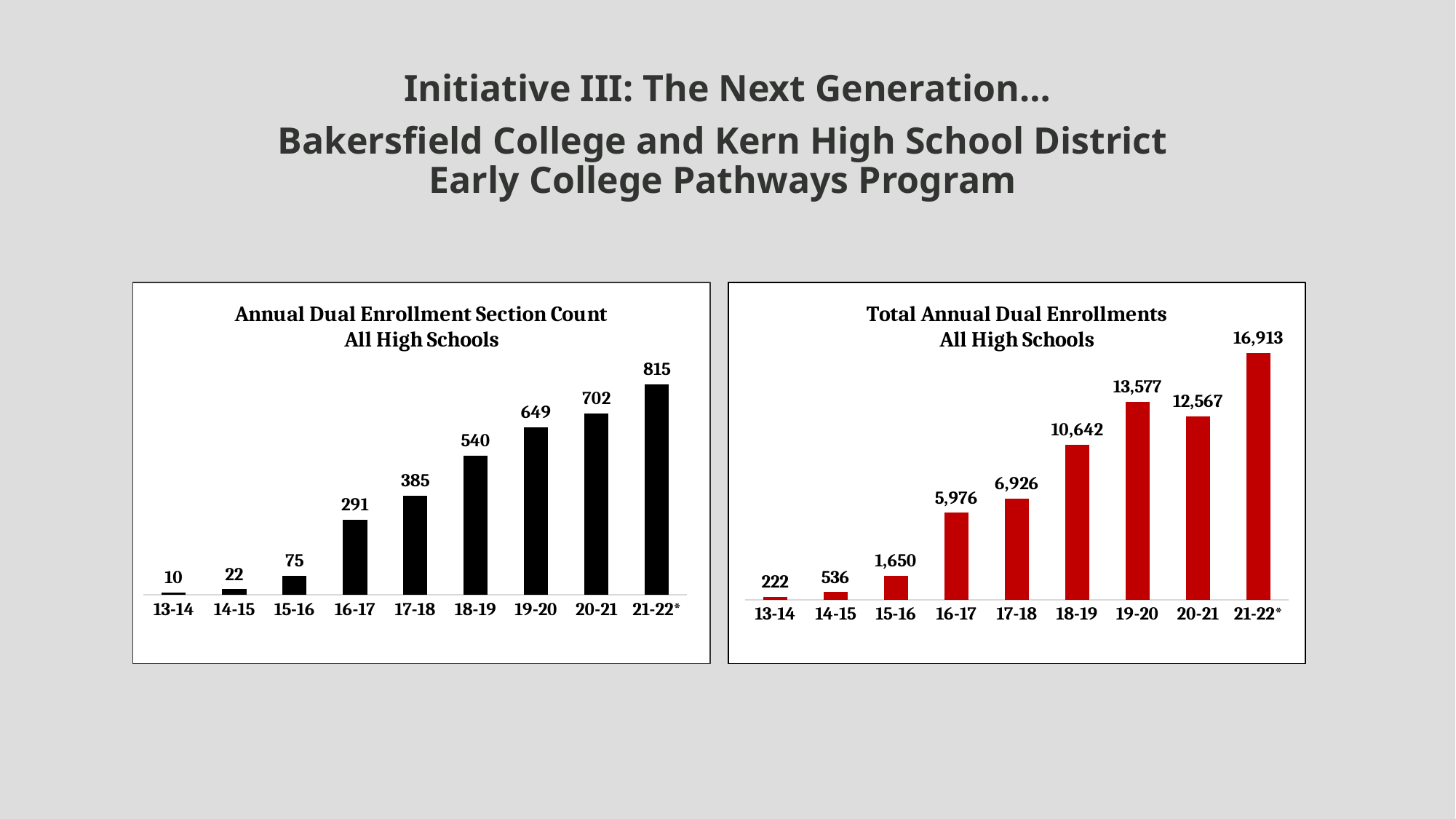
In the 'Annual Dual Enrollment Section Count All High Schools' chart, which is larger, the value for 16-17 or the value for 17-18? 17-18 In the 'Annual Dual Enrollment Section Count All High Schools' chart, what is the value for 18-19? 540 In the 'Annual Dual Enrollment Section Count All High Schools' chart, what is the difference between the values for 21-22* and 20-21? 113 How many years are shown on the x axis of the 'Annual Dual Enrollment Section Count All High Schools' chart? 9 In the 'Total Annual Dual Enrollments All High Schools' chart, what is the value for 16-17? 5,976 In the 'Total Annual Dual Enrollments All High Schools' chart, which year has the lowest value? 13-14 In the 'Annual Dual Enrollment Section Count All High Schools' chart, which year has the highest value? 21-22* In the 'Annual Dual Enrollment Section Count All High Schools' chart, do the values rise or fall from 13-14 to 21-22*? Rise In the 'Total Annual Dual Enrollments All High Schools' chart, which is larger, the value for 19-20 or the value for 20-21? 19-20 What kind of chart is the 'Total Annual Dual Enrollments All High Schools' chart? Bar chart In the 'Total Annual Dual Enrollments All High Schools' chart, what is the difference between the values for 19-20 and 20-21? 1,010 What colour are the bars in the 'Total Annual Dual Enrollments All High Schools' chart? Red